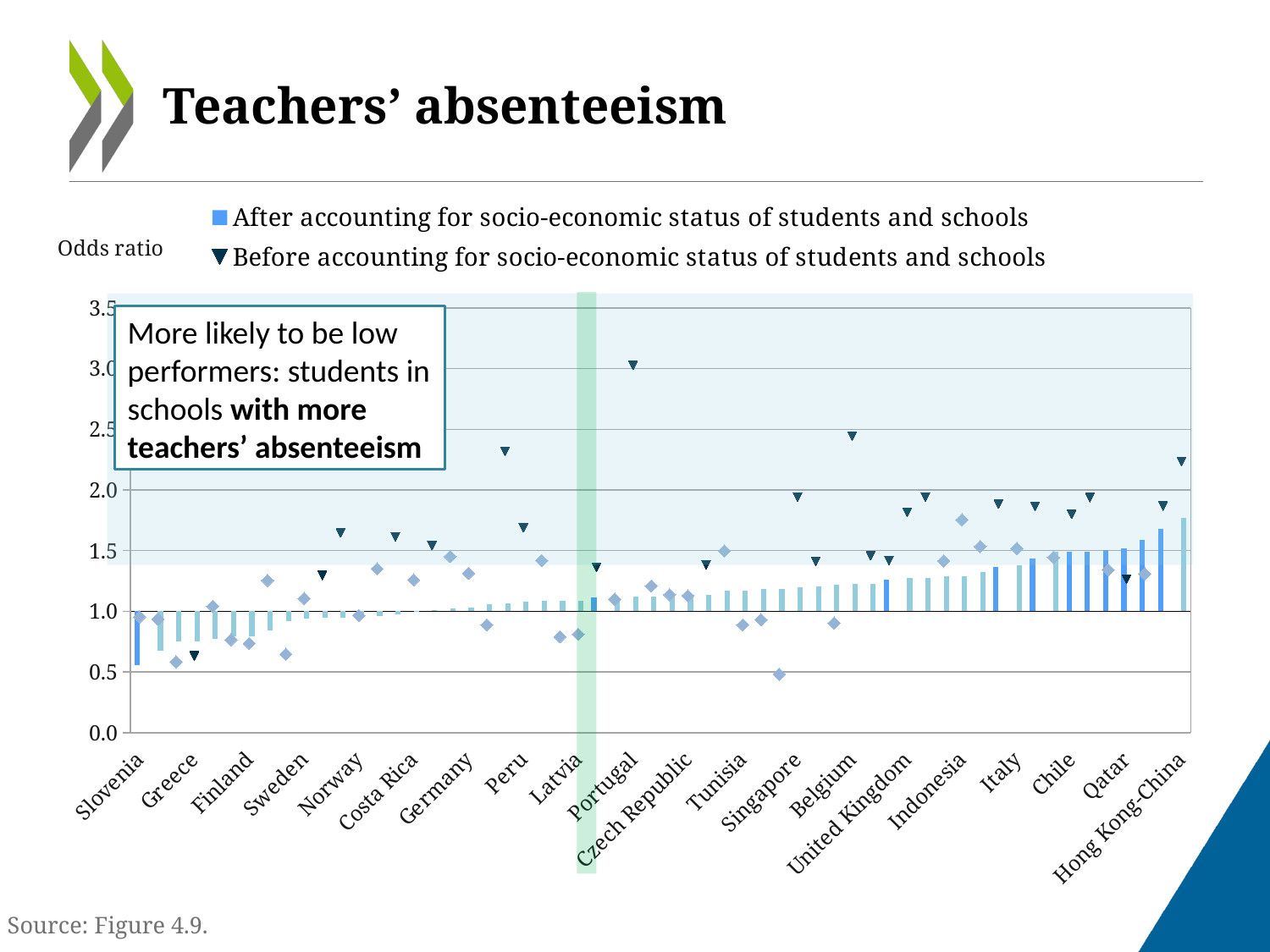
What kind of chart is shown on the slide? Bar chart Is the bar value (after accounting for socio-economic status) for Hong Kong-China greater or less than 1.5? greater Do the bar values (after accounting for socio-economic status) generally rise or fall from left to right across the countries? rise Is the 'Before accounting' marker for Hong Kong-China greater or less than 2.0? greater What is the title of the chart? Teachers' absenteeism Is the bar value (after accounting for socio-economic status) for Chile greater or less than 1.0? greater Which has the larger bar value (after accounting for socio-economic status): Slovenia or Hong Kong-China? Hong Kong-China How many series does the legend list? 2 Which country has the highest bar value (after accounting for socio-economic status)? Hong Kong-China What quantity is plotted on the vertical axis? Odds ratio